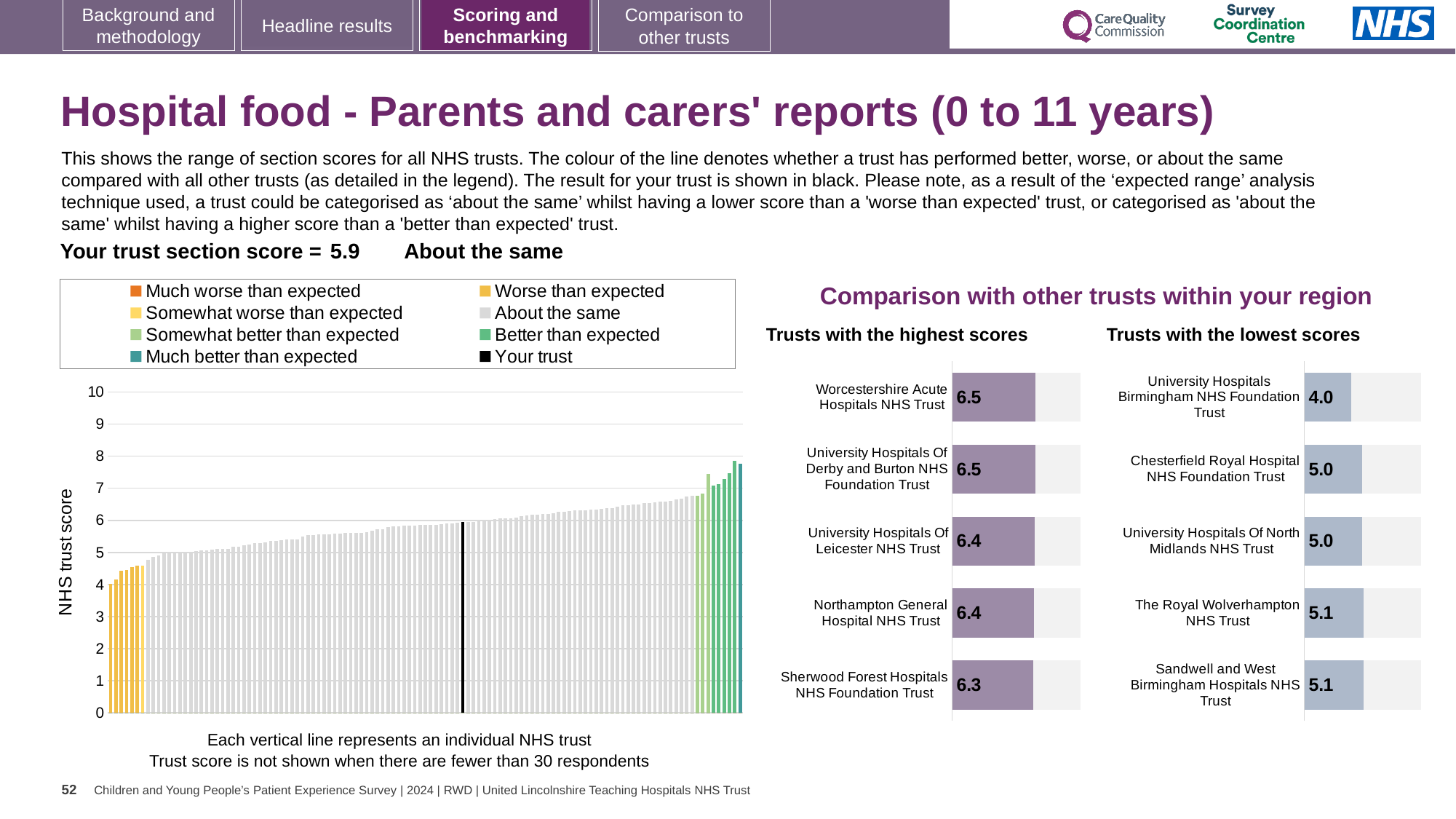
How many entries does the legend of the main NHS trust score chart list? 8 In the 'Trusts with the lowest scores' chart, which has the higher score: Chesterfield Royal Hospital NHS Foundation Trust or The Royal Wolverhampton NHS Trust? The Royal Wolverhampton NHS Trust What type of chart is the main chart showing NHS trust scores on the left of the slide? Bar chart In the main NHS trust score chart, do the bars rise or fall from left to right? Rise In the 'Trusts with the lowest scores' chart, which trust has the lowest score? University Hospitals Birmingham NHS Foundation Trust In the 'Trusts with the highest scores' chart, what is the score for Sherwood Forest Hospitals NHS Foundation Trust? 6.3 How many trusts are listed in the 'Trusts with the highest scores' chart? 5 In the 'Trusts with the lowest scores' chart, what is the difference between the scores of Sandwell and West Birmingham Hospitals NHS Trust and University Hospitals Birmingham NHS Foundation Trust? 1.1 In the 'Trusts with the highest scores' chart, what is the difference between the scores of Worcestershire Acute Hospitals NHS Trust and Sherwood Forest Hospitals NHS Foundation Trust? 0.2 What is the section score for your trust shown in the main NHS trust score chart? 5.9 In the 'Trusts with the highest scores' chart, what is the score for Worcestershire Acute Hospitals NHS Trust? 6.5 In the 'Trusts with the lowest scores' chart, what is the score for University Hospitals Birmingham NHS Foundation Trust? 4.0